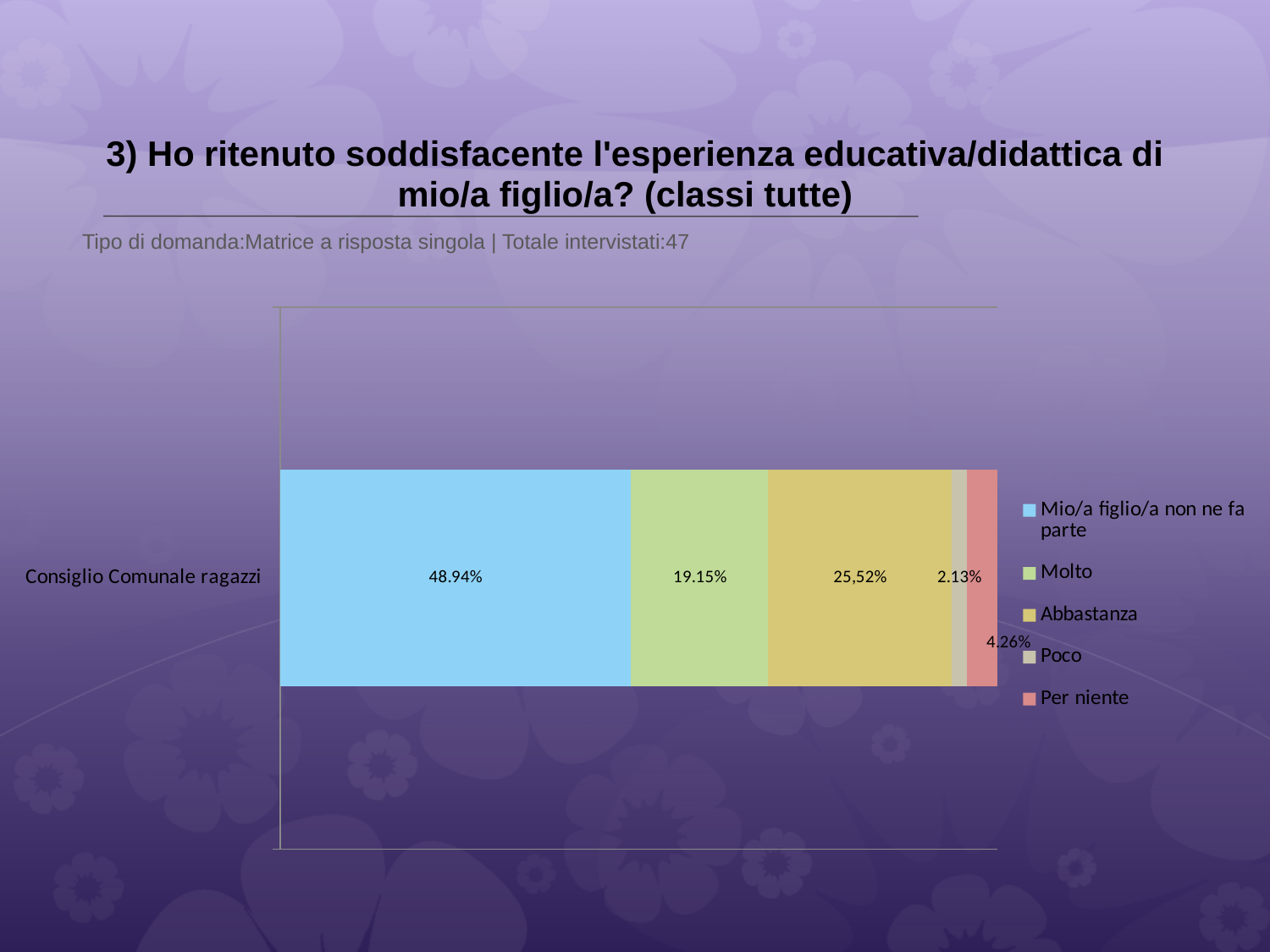
What kind of chart is shown on the slide? Stacked bar chart What is the category label shown on the chart's axis? Consiglio Comunale ragazzi What is the value for 'Poco' in the Consiglio Comunale ragazzi bar? 2.13% Which is larger, the value for 'Molto' or the value for 'Abbastanza'? Abbastanza What is the value for 'Abbastanza' in the Consiglio Comunale ragazzi bar? 25,52% Which series has the largest share of the Consiglio Comunale ragazzi bar? Mio/a figlio/a non ne fa parte How many series does the legend list? 5 What is the value for 'Mio/a figlio/a non ne fa parte' in the Consiglio Comunale ragazzi bar? 48.94% What is the difference between the value for 'Mio/a figlio/a non ne fa parte' and the value for 'Molto'? 29.79% What is the value for 'Molto' in the Consiglio Comunale ragazzi bar? 19.15% What is the value for 'Per niente' in the Consiglio Comunale ragazzi bar? 4.26% Which series has the smallest share of the Consiglio Comunale ragazzi bar? Poco